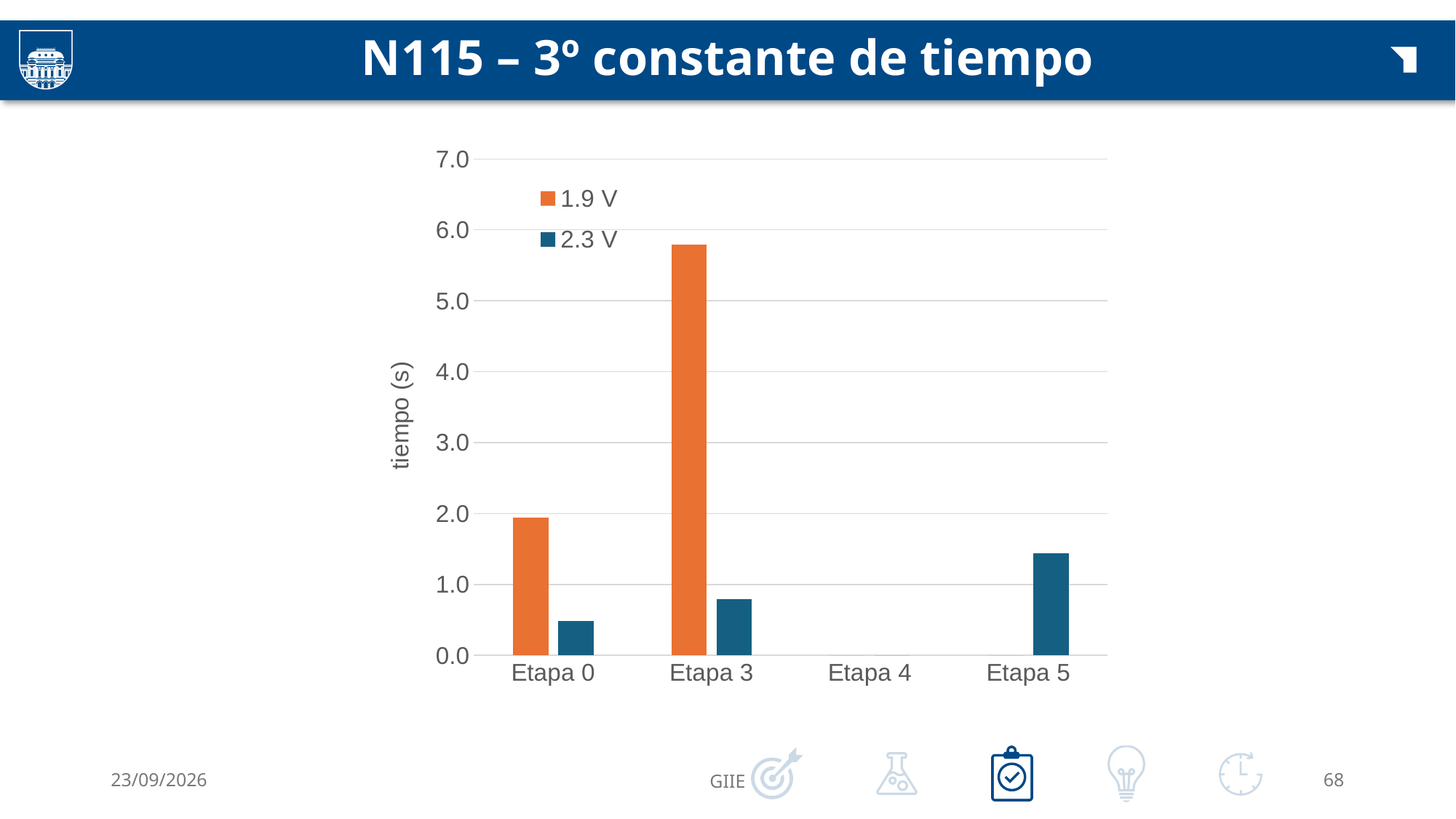
What kind of chart is shown on the slide? bar chart At Etapa 3, which series has the larger value, 1.9 V or 2.3 V? 1.9 V Is the value for 1.9 V at Etapa 3 greater or less than 5.0? greater How many series does the legend list? 2 What is the label of the y axis? tiempo (s) How many categories are shown on the x axis? 4 Which category has the highest value for the 2.3 V series? Etapa 5 Is the value for 1.9 V at Etapa 0 greater or less than 3.0? less Which category has the highest value for the 1.9 V series? Etapa 3 Which colour represents the 2.3 V series in the legend? blue Is the value for 2.3 V at Etapa 0 greater or less than 1.0? less